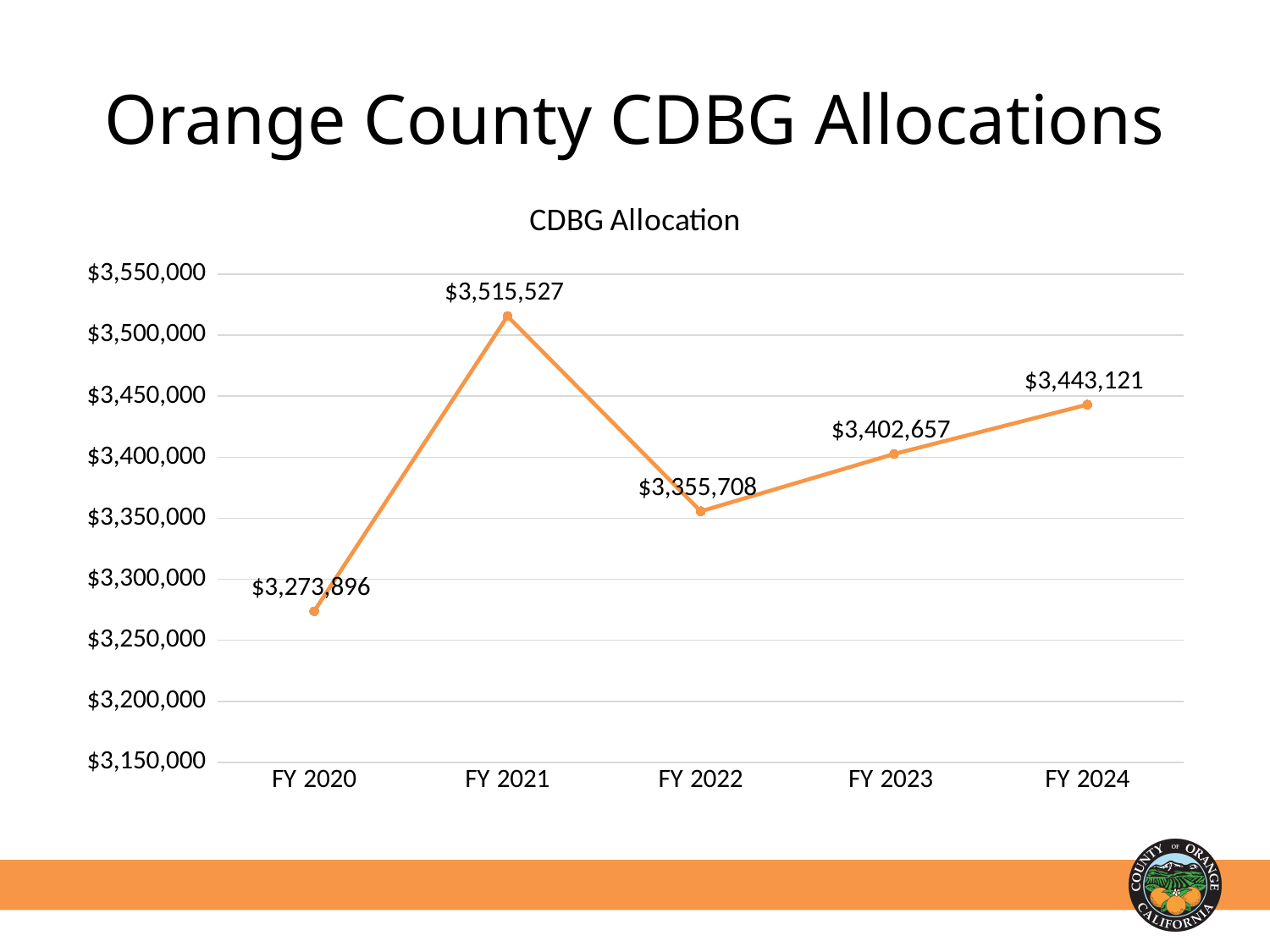
What kind of chart is shown on the slide? line chart What is the CDBG allocation for FY 2020? $3,273,896 Which fiscal year has the lowest CDBG allocation? FY 2020 How many fiscal years are plotted on the chart? 5 What is the CDBG allocation for FY 2023? $3,402,657 Is the CDBG allocation for FY 2022 greater or less than $3,400,000? less What is the CDBG allocation for FY 2021? $3,515,527 Do the CDBG allocations rise or fall from FY 2022 to FY 2024? rise Which fiscal year has the highest CDBG allocation? FY 2021 Which is larger, the CDBG allocation for FY 2022 or for FY 2024? FY 2024 How much larger is the FY 2021 allocation than the FY 2020 allocation? $241,631 What is the difference between the FY 2024 and FY 2023 allocations? $40,464